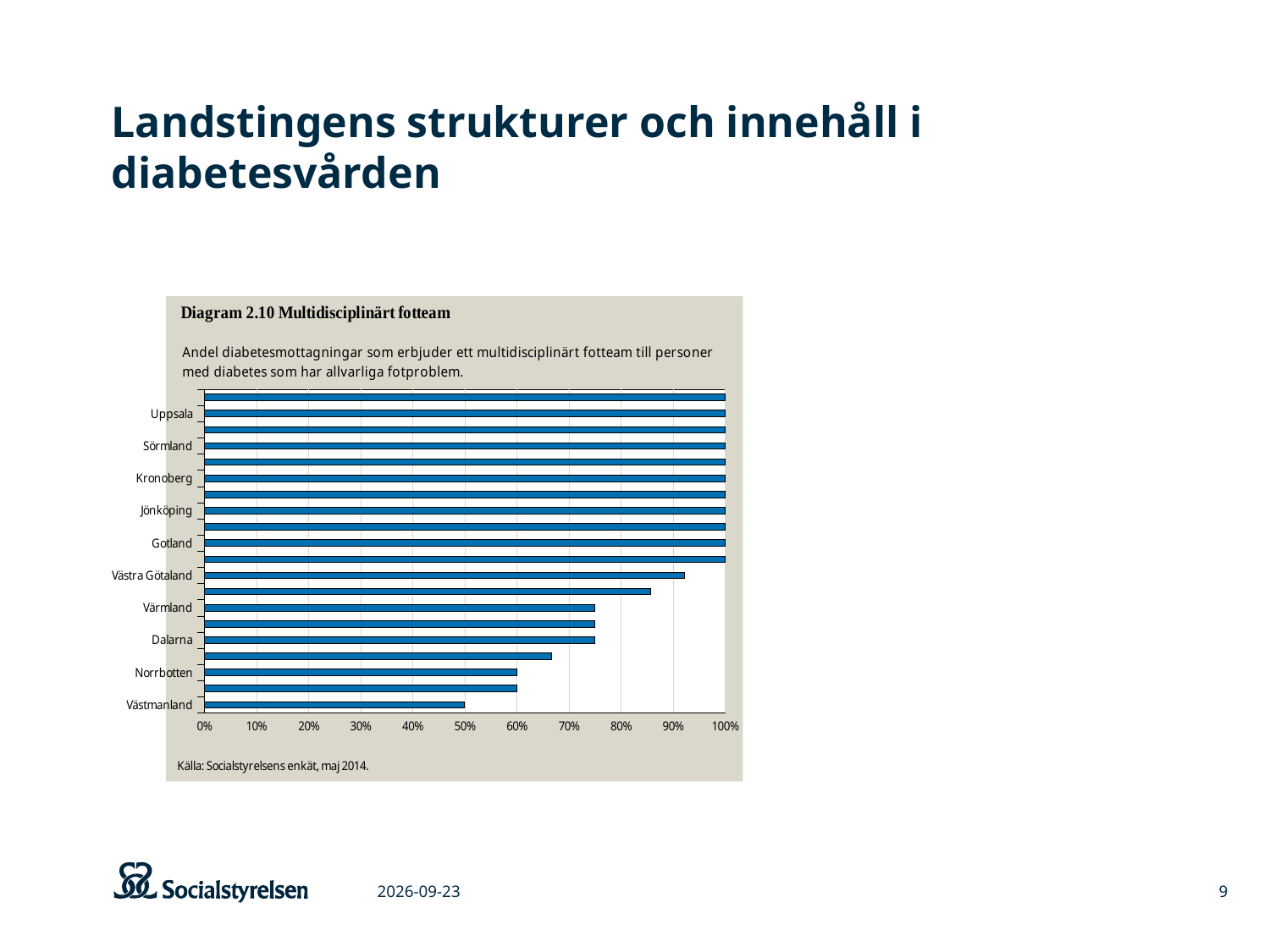
Is the value for Värmland greater or less than 80%? less What is the value for Uppsala? 100% What is the difference between the value for Uppsala and the value for Västmanland? 50 percentage points Is the value for Västra Götaland greater or less than 90%? greater What is the value for Norrbotten? 60% What is the title of the diagram? Diagram 2.10 Multidisciplinärt fotteam Is the value for Dalarna greater or less than 70%? greater What is the value for Västmanland? 50% What is the value for Gotland? 100% What kind of chart is shown on the slide? Bar chart Which is larger, the value for Kronoberg or the value for Dalarna? Kronoberg Which labelled county has the lowest value? Västmanland